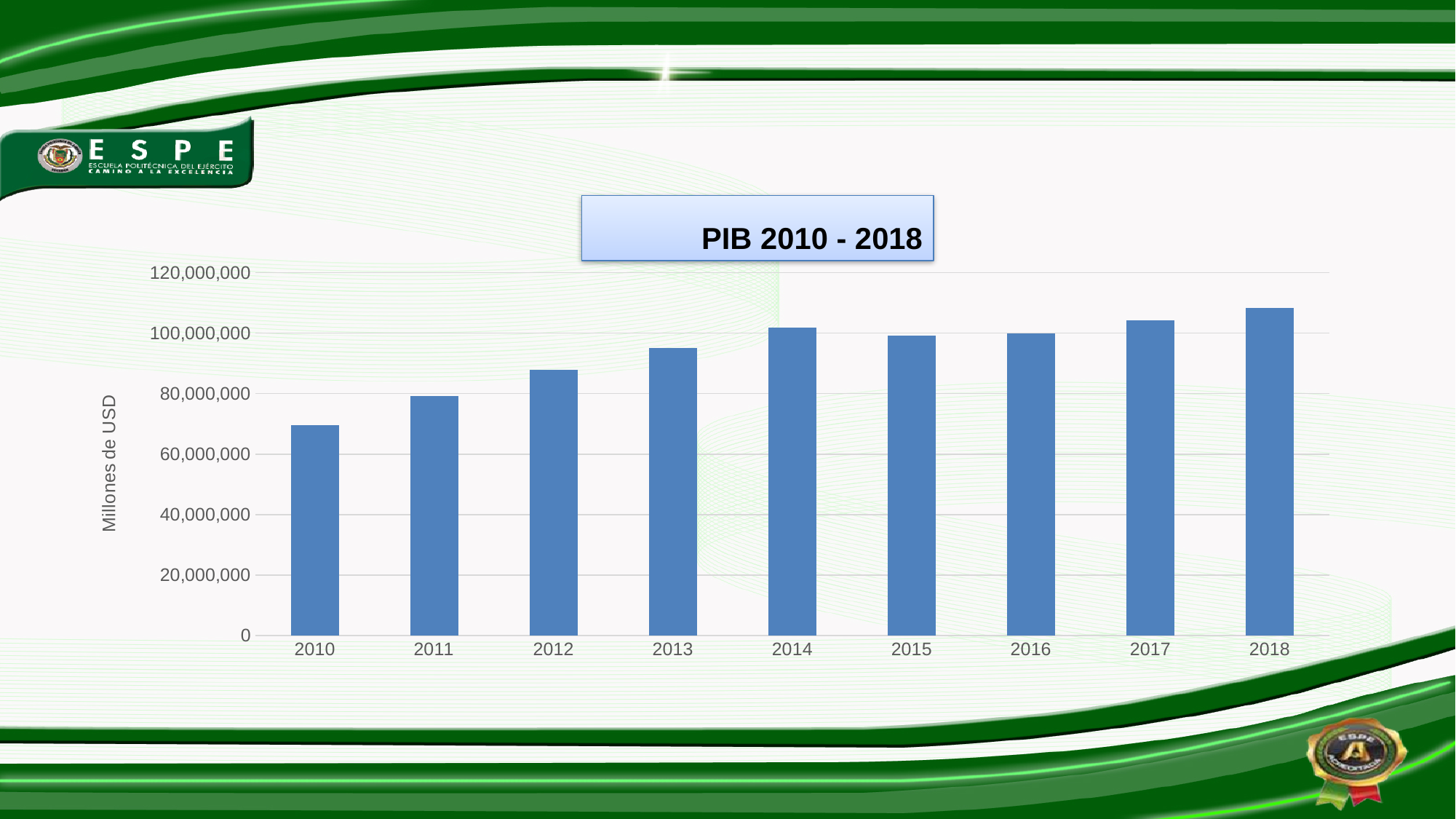
Which year has the larger value, 2013 or 2017? 2017 Is the value for 2012 greater or less than 80,000,000? greater Is the value for 2013 greater or less than 100,000,000? less Is the value for 2010 greater or less than 80,000,000? less Which year has the highest value on the chart? 2018 What is the title of the chart? PIB 2010 - 2018 Which year has the lowest value on the chart? 2010 What is the label on the vertical axis of the chart? Millones de USD How many years are plotted on the chart? 9 Do the values generally rise or fall from 2010 to 2018? rise What kind of chart is shown on the slide? bar chart